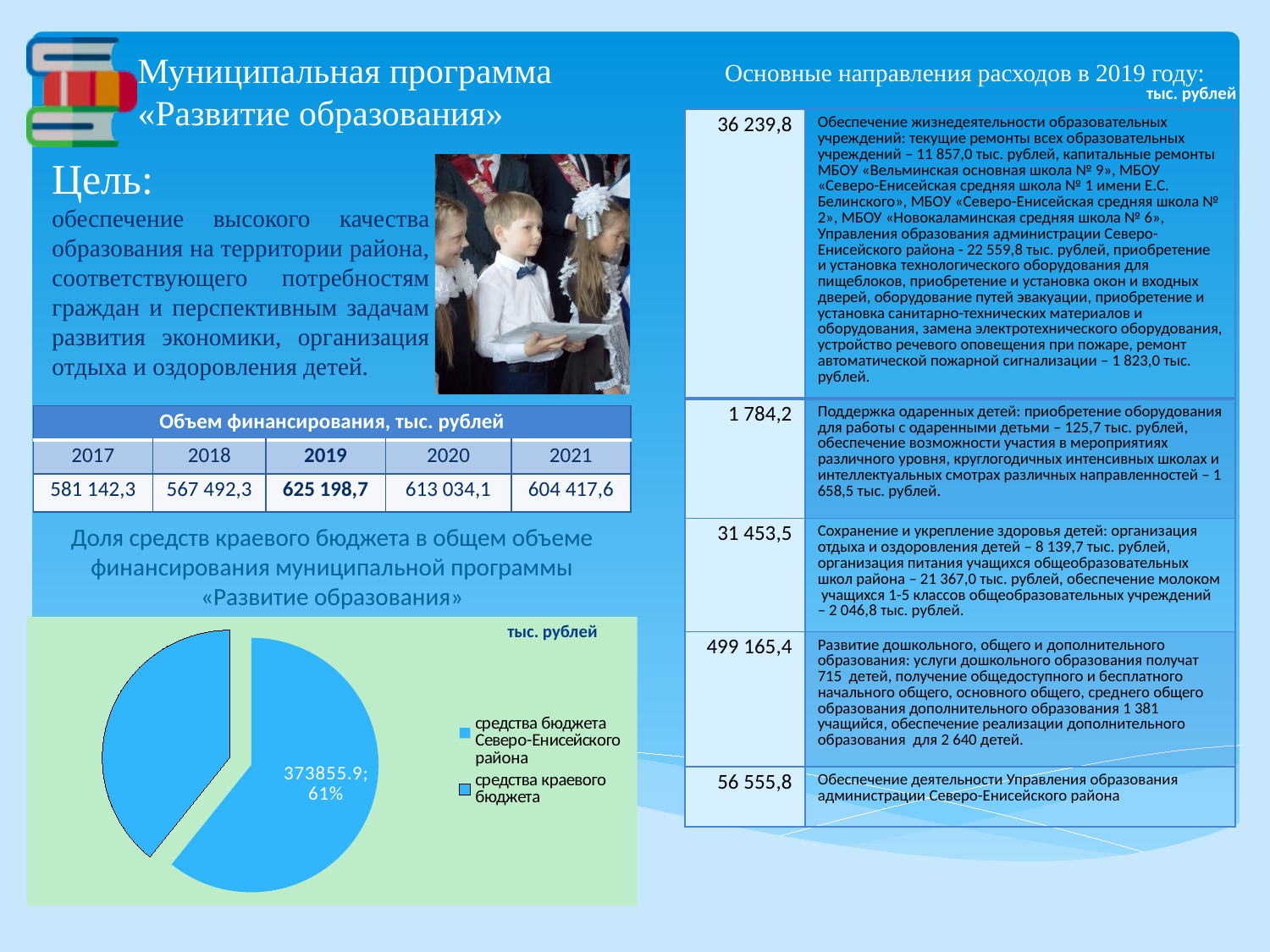
How many slices does the pie chart have? 2 Is the share of the labelled slice of the pie chart greater or less than 50%? greater What percentage share is printed on the labelled slice of the pie chart? 61% How many entries does the legend of the pie chart list? 2 What are the two legend entries of the pie chart? средства бюджета Северо-Енисейского района; средства краевого бюджета What unit is indicated above the legend of the pie chart? тыс. рублей What value is printed on the labelled slice of the pie chart? 373855.9 What kind of chart is shown on the slide? pie chart